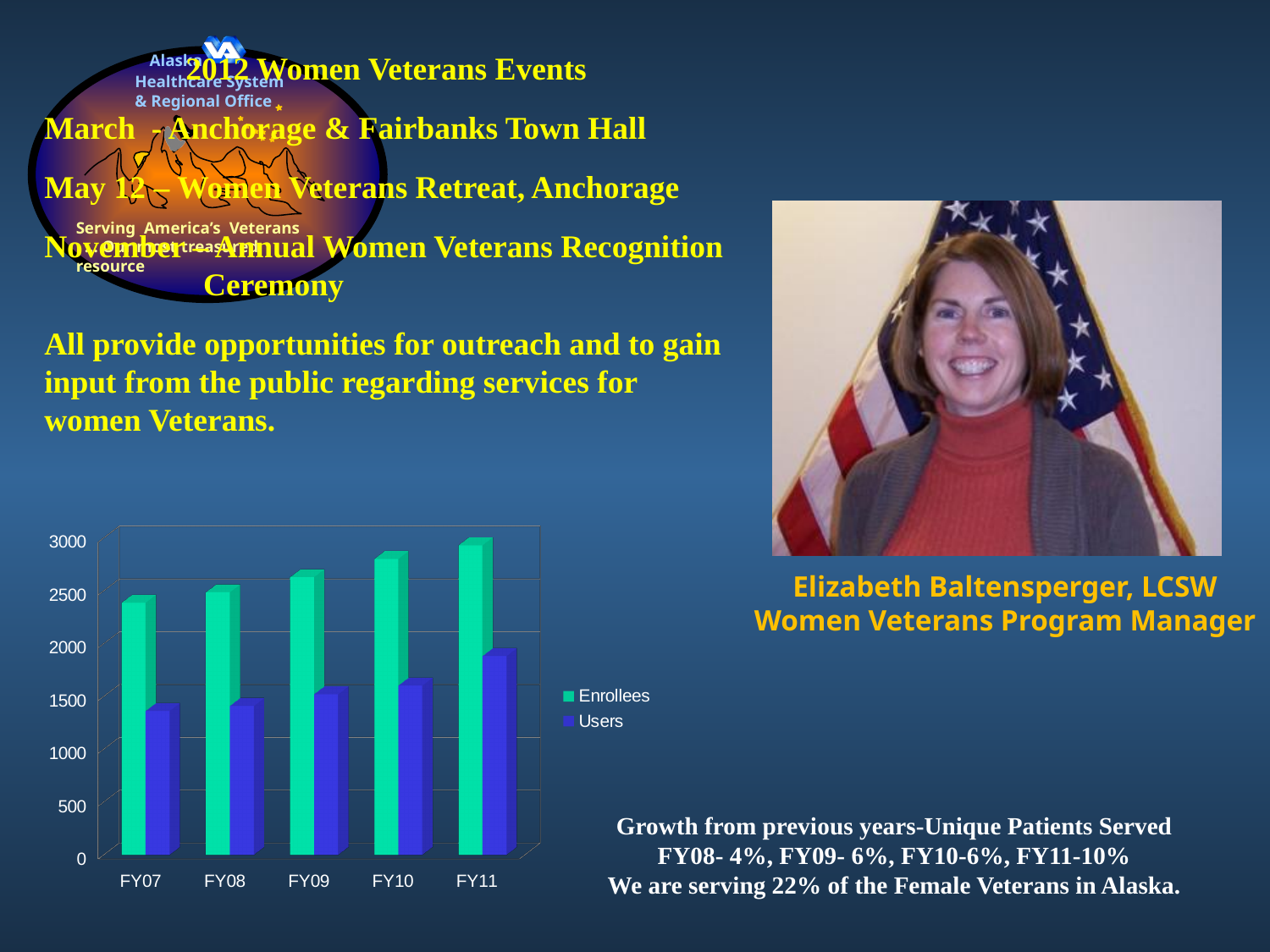
How many fiscal years are shown on the x axis of the chart? 5 Is the Users value for FY11 greater or less than 1500? greater How many series does the chart legend list? 2 Is the Enrollees value for FY11 greater or less than 2500? greater Do the Enrollees values rise or fall from FY07 to FY11? rise Is the Enrollees value for FY07 greater or less than 2000? greater Which fiscal year has the lowest Enrollees value? FY07 In FY09, which is larger, Enrollees or Users? Enrollees What are the two series named in the chart legend? Enrollees and Users Which fiscal year has the highest Users value? FY11 Which fiscal year has the highest Enrollees value? FY11 What kind of chart is shown on the slide? bar chart